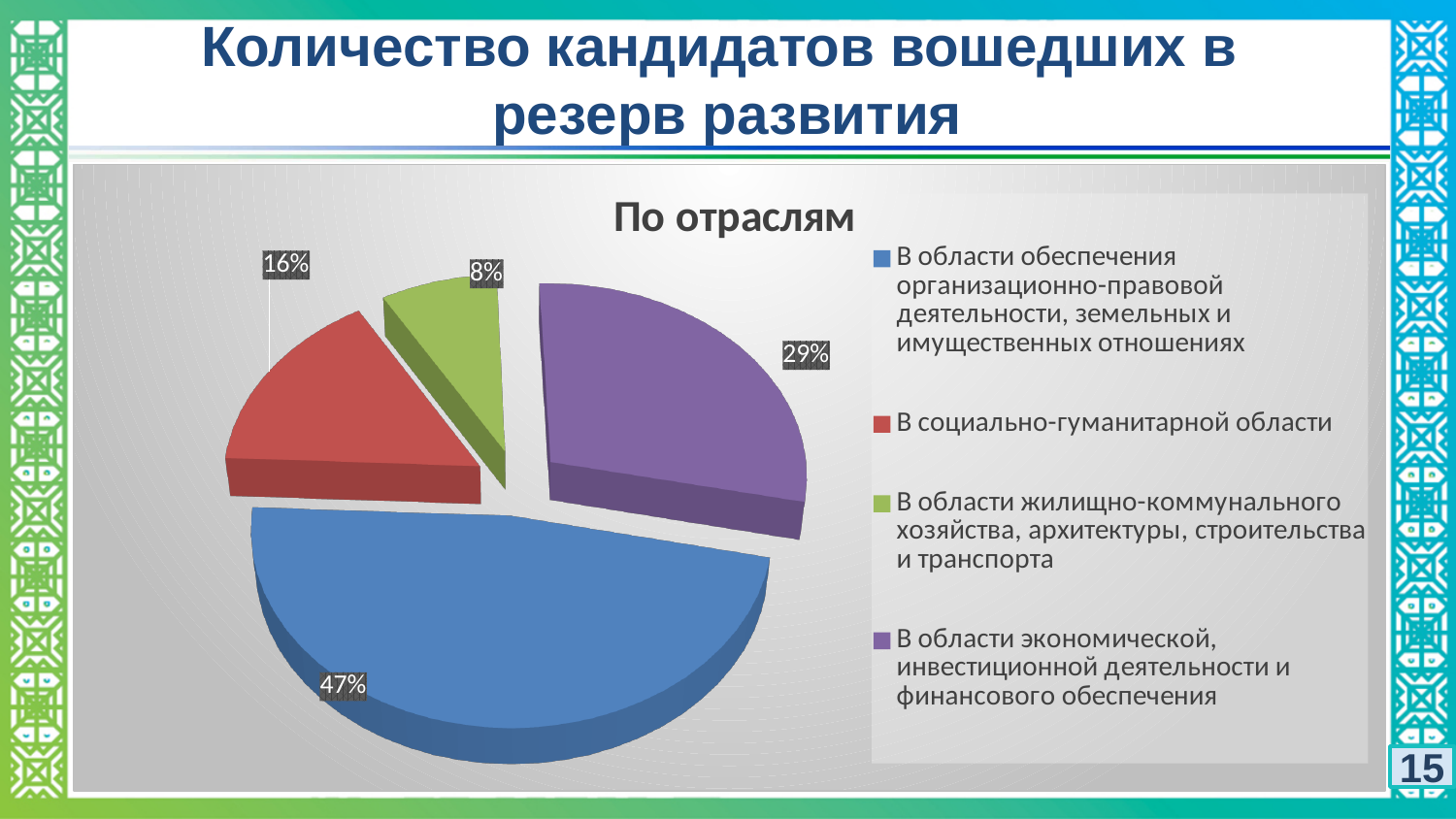
What share of the pie is 'В области экономической, инвестиционной деятельности и финансового обеспечения'? 29% What is the difference in percentage points between the share for 'В области экономической, инвестиционной деятельности и финансового обеспечения' and the share for 'В социально-гуманитарной области'? 13% Which category has the smallest share of the pie? В области жилищно-коммунального хозяйства, архитектуры, строительства и транспорта How many slices does the pie chart have? 4 What share of the pie is 'В области обеспечения организационно-правовой деятельности, земельных и имущественных отношениях'? 47% What kind of chart is shown on the slide? Pie chart What share of the pie is 'В области жилищно-коммунального хозяйства, архитектуры, строительства и транспорта'? 8% How many entries does the legend list? 4 Which is larger: the share for 'В социально-гуманитарной области' or the share for 'В области жилищно-коммунального хозяйства, архитектуры, строительства и транспорта'? В социально-гуманитарной области What is the title of the chart? По отраслям Which category has the largest share of the pie? В области обеспечения организационно-правовой деятельности, земельных и имущественных отношениях